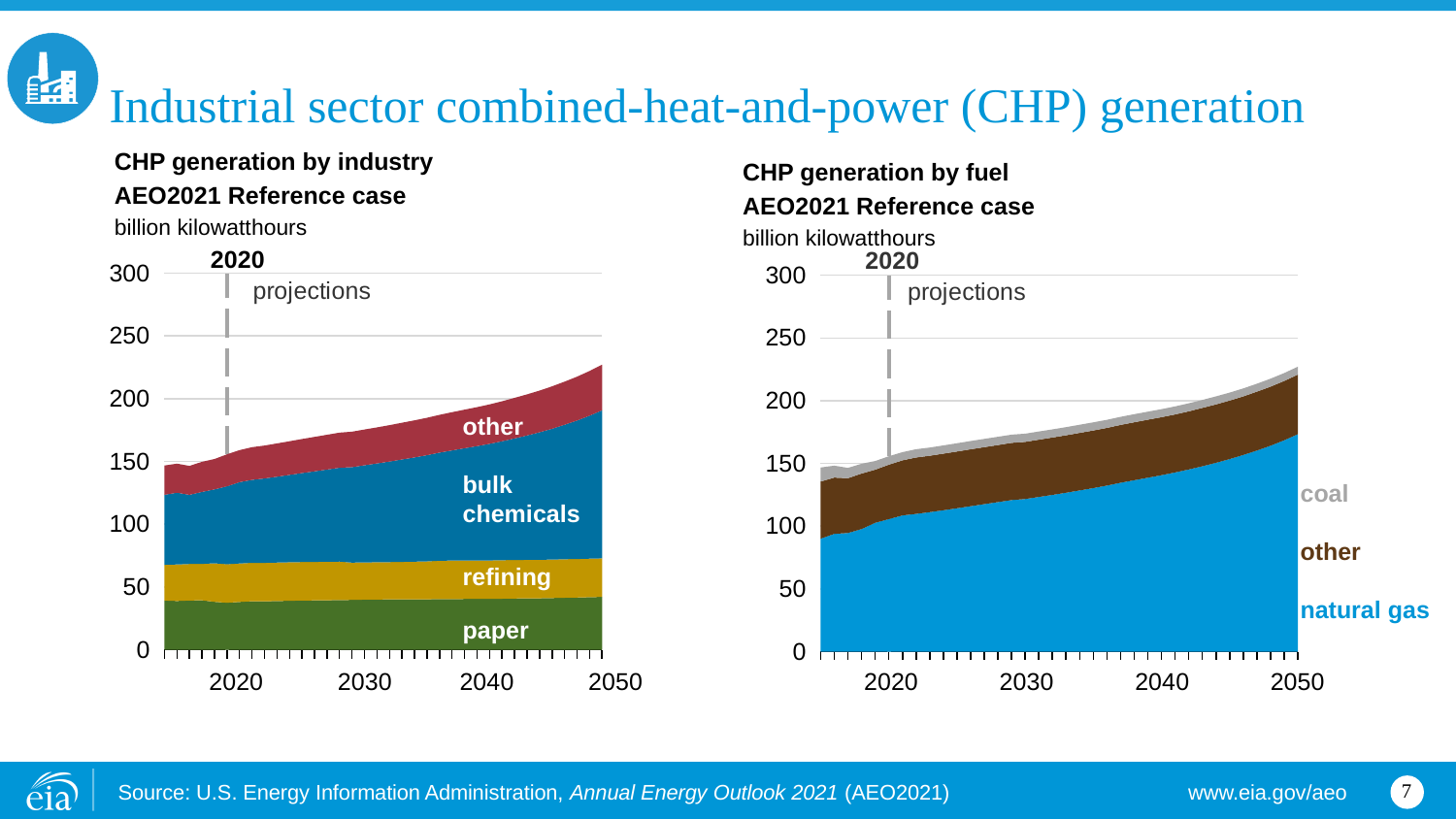
In the 'CHP generation by fuel' chart, does natural gas CHP generation rise or fall over the projection period? rise In the 'CHP generation by industry' chart, is CHP generation from paper in 2050 greater or less than 50 billion kilowatthours? less What unit is used on the y axis of both charts? billion kilowatthours In the 'CHP generation by industry' chart, is total CHP generation in 2050 greater or less than 200 billion kilowatthours? greater In the 'CHP generation by fuel' chart, is natural gas CHP generation in 2050 greater or less than 150 billion kilowatthours? greater How many fuel series are shown in the 'CHP generation by fuel' chart? 3 In the 'CHP generation by industry' chart, does total CHP generation rise or fall from 2020 to 2050? rise In the 'CHP generation by fuel' chart, which fuel contributes the least CHP generation in 2050? coal How many industry series are shown in the 'CHP generation by industry' chart? 4 In the 'CHP generation by industry' chart, which industry contributes the most CHP generation in 2050? bulk chemicals What kind of chart is the 'CHP generation by industry' chart? stacked area chart In the 'CHP generation by fuel' chart, which fuel contributes more CHP generation in 2050, natural gas or coal? natural gas